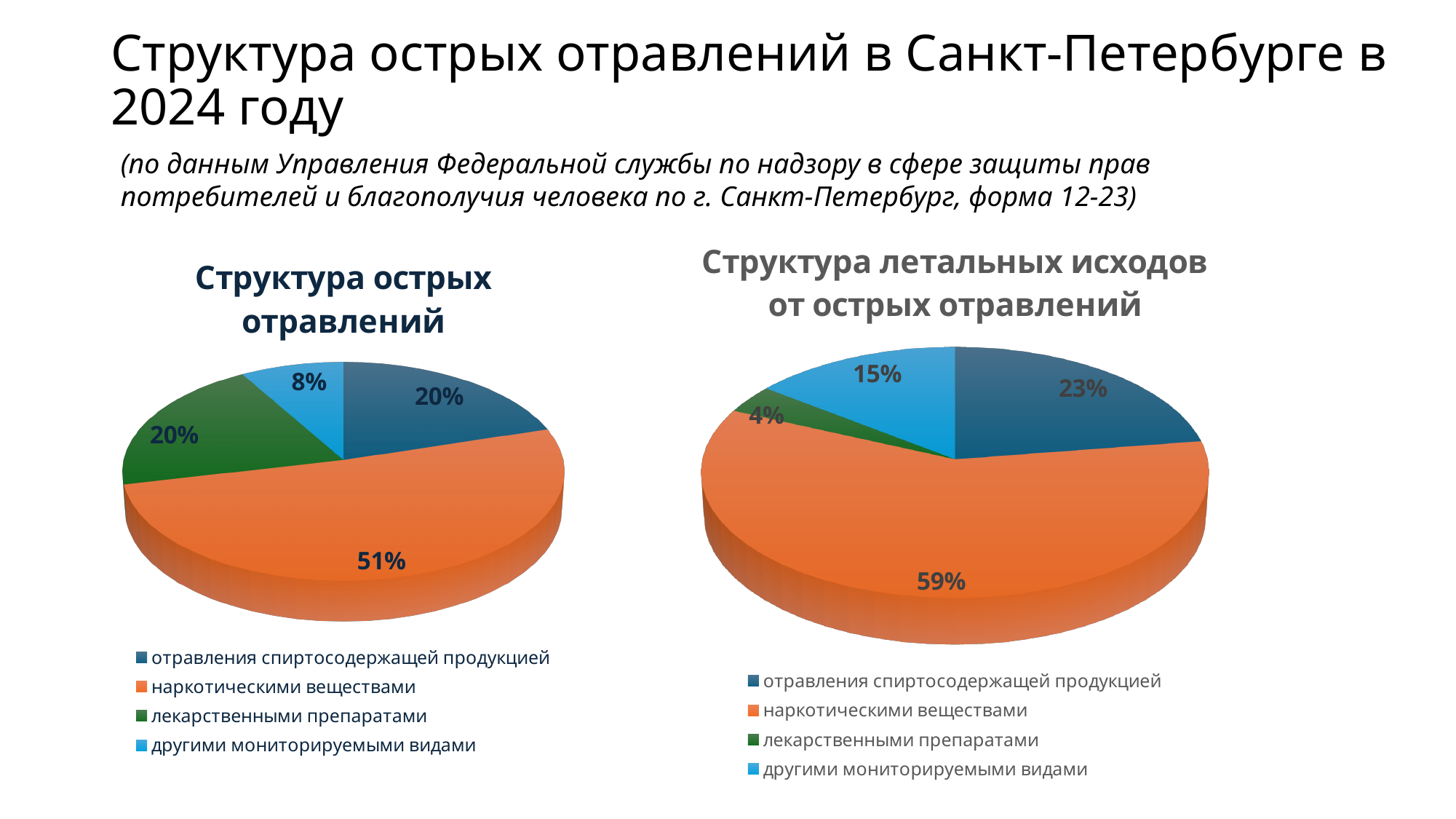
На диаграмме «Структура острых отравлений» какая категория имеет наименьшую долю? другими мониторируемыми видами На диаграмме «Структура летальных исходов от острых отравлений» какая категория имеет наибольшую долю? наркотическими веществами Сколько категорий показано на диаграмме «Структура острых отравлений»? 4 На диаграмме «Структура летальных исходов от острых отравлений» какая категория имеет наименьшую долю? лекарственными препаратами На диаграмме «Структура острых отравлений» какая доля приходится на отравления другими мониторируемыми видами? 8% На диаграмме «Структура острых отравлений» какая доля приходится на отравления наркотическими веществами? 51% Какого типа диаграмма «Структура летальных исходов от острых отравлений»? круговая диаграмма Каким цветом на диаграмме «Структура острых отравлений» обозначены отравления лекарственными препаратами? зелёным На диаграмме «Структура летальных исходов от острых отравлений» какая доля приходится на отравления спиртосодержащей продукцией? 23% На диаграмме «Структура летальных исходов от острых отравлений» какая доля приходится на отравления лекарственными препаратами? 4% На диаграмме «Структура летальных исходов от острых отравлений» на сколько процентных пунктов доля наркотических веществ больше доли спиртосодержащей продукции? 36 На диаграмме «Структура острых отравлений» что больше: доля спиртосодержащей продукции или доля других мониторируемых видов? спиртосодержащей продукции